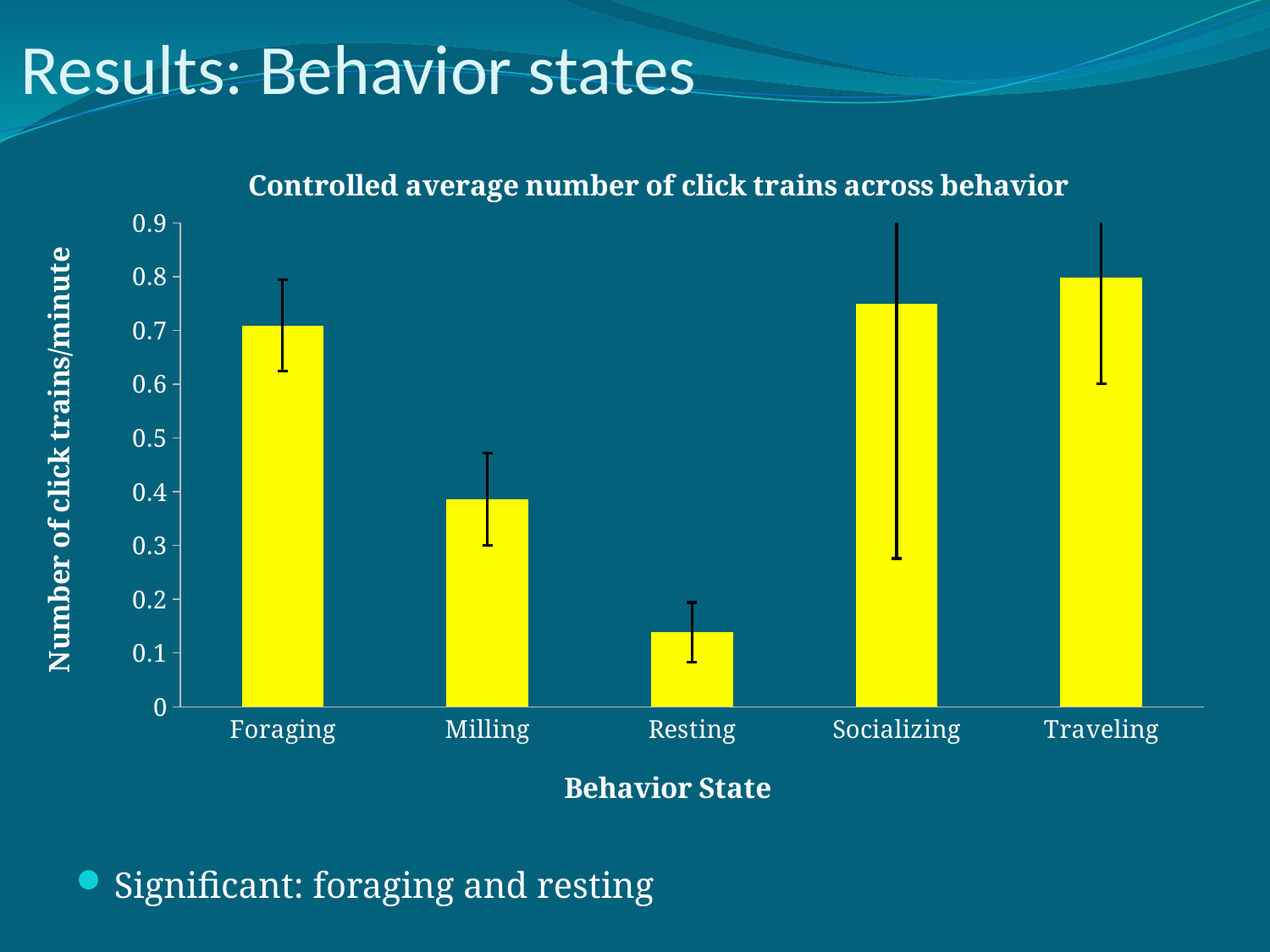
Which behavior state has the lowest number of click trains per minute? Resting Is the value for Socializing greater or less than 0.7? greater Is the value for Resting greater or less than 0.2? less Is the value for Milling greater or less than 0.5? less How many behavior states are plotted on the x axis? 5 Which has a higher number of click trains per minute, Resting or Milling? Milling What is the title of the chart? Controlled average number of click trains across behavior What kind of chart is shown on the slide? Bar chart Which behavior state has the highest number of click trains per minute? Traveling Which has a higher number of click trains per minute, Foraging or Milling? Foraging